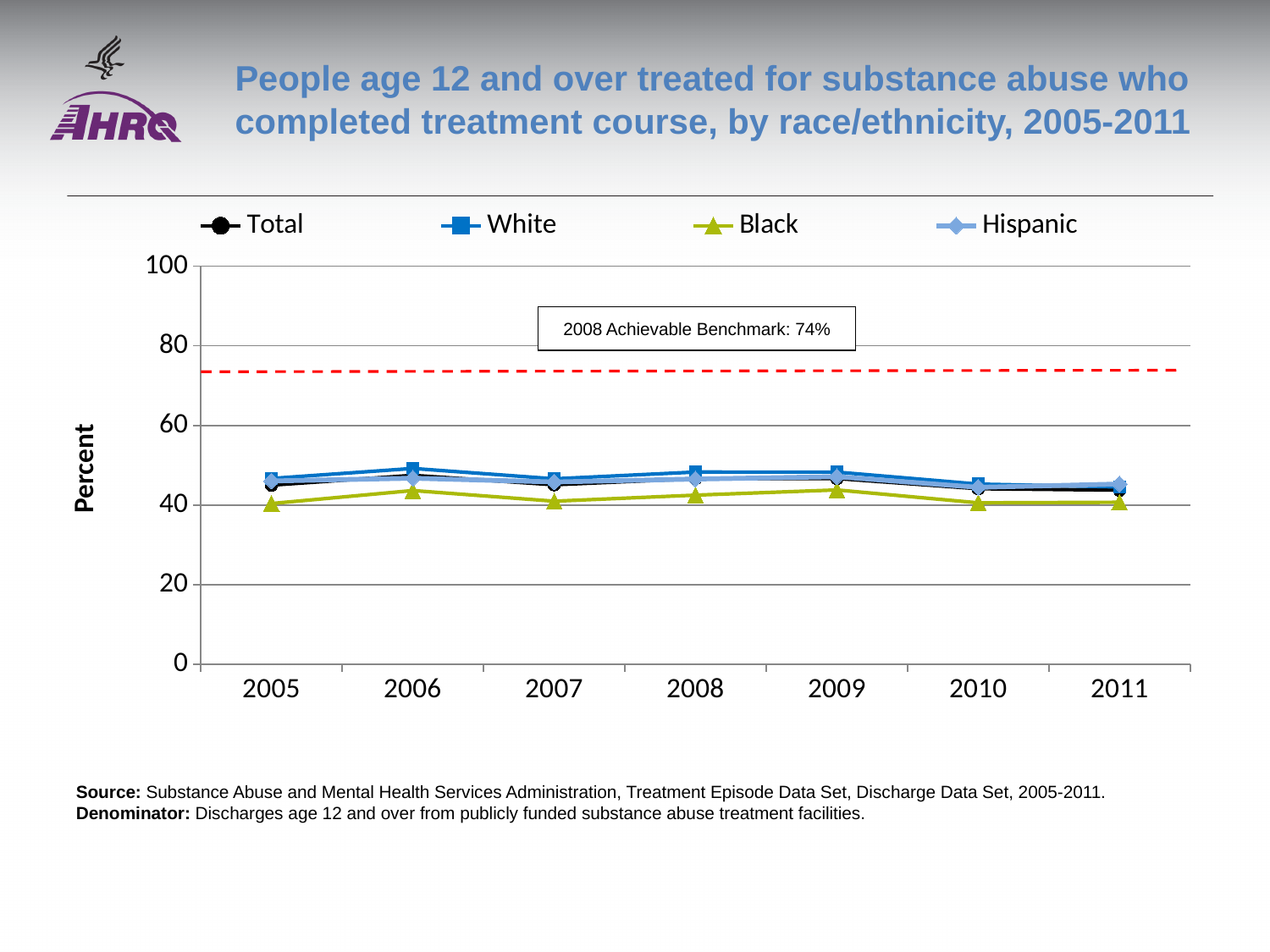
How many series does the legend list? 4 What is the 2008 Achievable Benchmark shown on the chart? 74% Is the value for Hispanic in 2009 greater or less than 20? greater How many years are plotted along the x axis? 7 Which series has the lowest value in 2006? Black What is the label of the y axis? Percent Is the value for Total in 2011 greater or less than 60? less Is the value for White in 2006 greater or less than 40? greater Which series has the lowest value in 2010? Black In 2008, which is larger: the value for White or the value for Black? White What kind of chart is shown on the slide? line chart